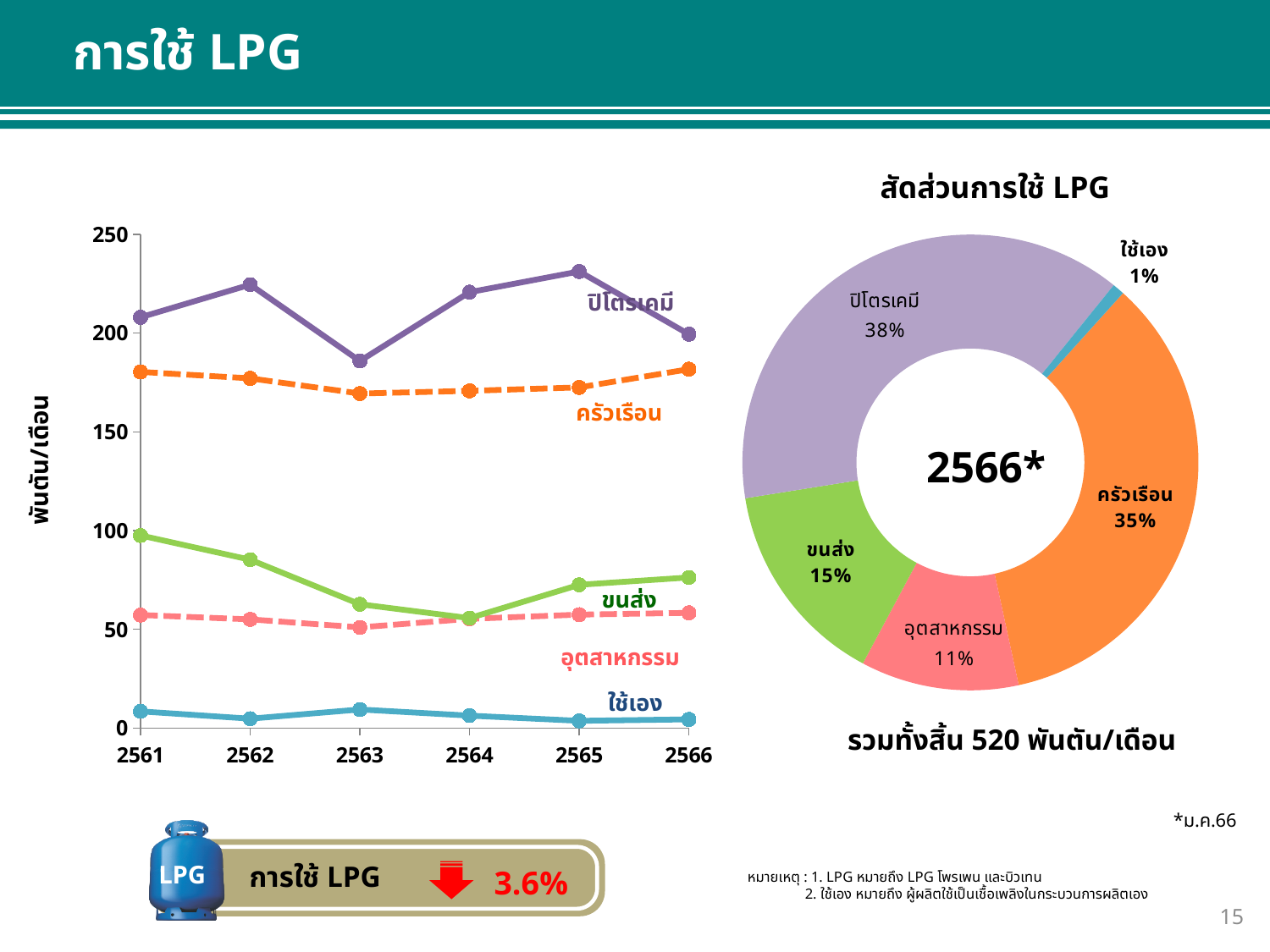
In the donut chart titled สัดส่วนการใช้ LPG, how many categories are shown? 5 In the line chart on the left, is the value for ปิโตรเคมี in 2563 greater or less than 150? greater In the line chart on the left, which series has the highest value in 2561? ปิโตรเคมี In the donut chart titled สัดส่วนการใช้ LPG, what share does ขนส่ง have? 15% In the line chart on the left, is the value for ใช้เอง in 2563 greater or less than 50? less In the line chart on the left, does the ขนส่ง series rise or fall from 2561 to 2564? fall In the donut chart titled สัดส่วนการใช้ LPG, which category has the smallest share? ใช้เอง What total is stated below the donut chart titled สัดส่วนการใช้ LPG? 520 พันตัน/เดือน In the donut chart titled สัดส่วนการใช้ LPG, what share does ปิโตรเคมี have? 38% What kind of chart is the chart on the left side of the slide? line chart In the donut chart titled สัดส่วนการใช้ LPG, how many percentage points larger is the ครัวเรือน share than the อุตสาหกรรม share? 24 In the donut chart titled สัดส่วนการใช้ LPG, which category has the largest share? ปิโตรเคมี